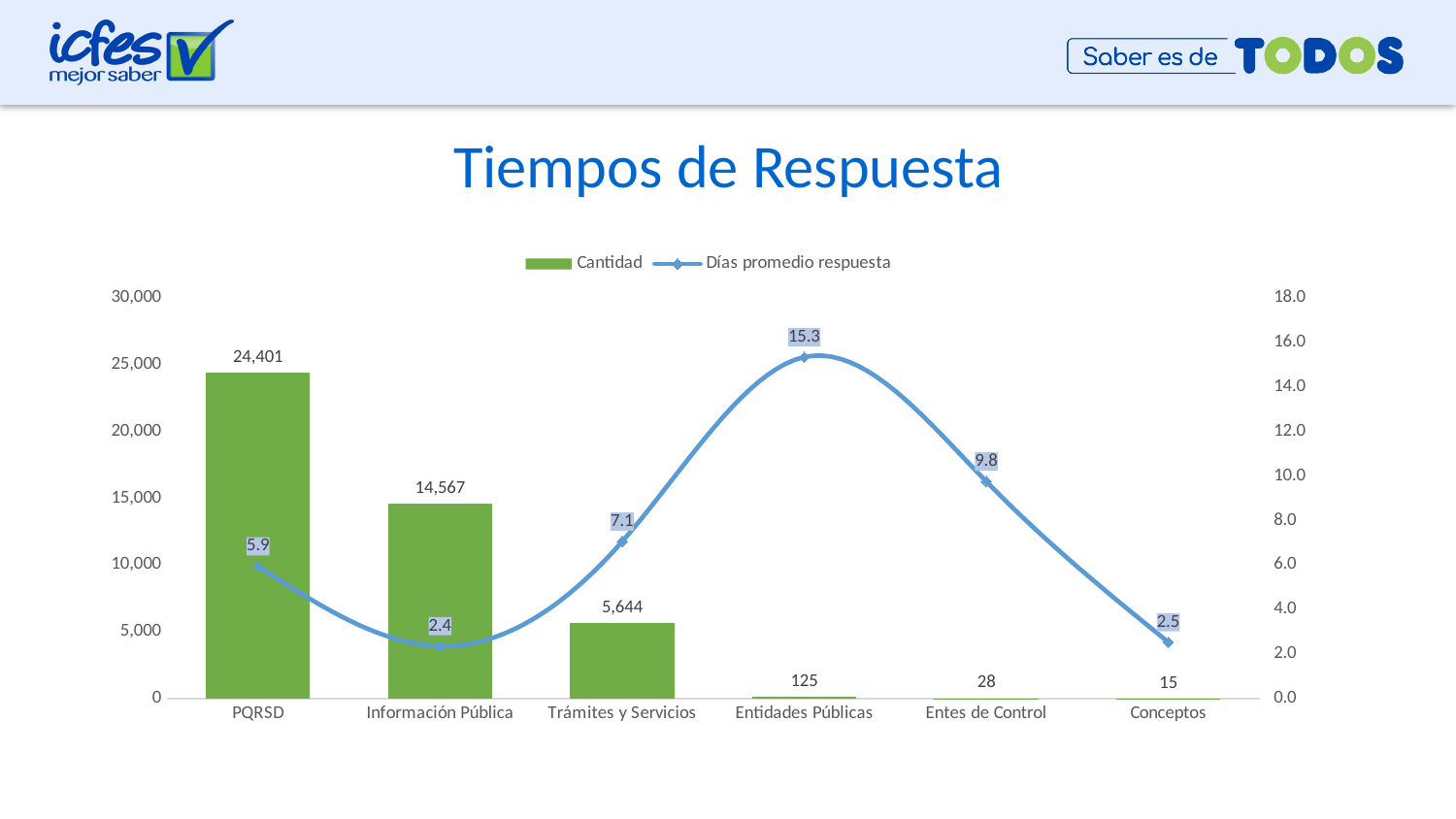
What is the Días promedio respuesta value for Información Pública? 2.4 What is the difference in Cantidad between PQRSD and Información Pública? 9,834 How many series does the legend list? 2 What is the Días promedio respuesta value for Entidades Públicas? 15.3 Which category has the lowest Días promedio respuesta? Información Pública What is the Cantidad value for PQRSD? 24,401 What is the Cantidad value for Trámites y Servicios? 5,644 Which has a higher Días promedio respuesta, Entes de Control or Trámites y Servicios? Entes de Control Which category has the highest Cantidad? PQRSD What is the Cantidad value for Conceptos? 15 How many categories are shown on the x axis? 6 What is the title of the chart? Tiempos de Respuesta